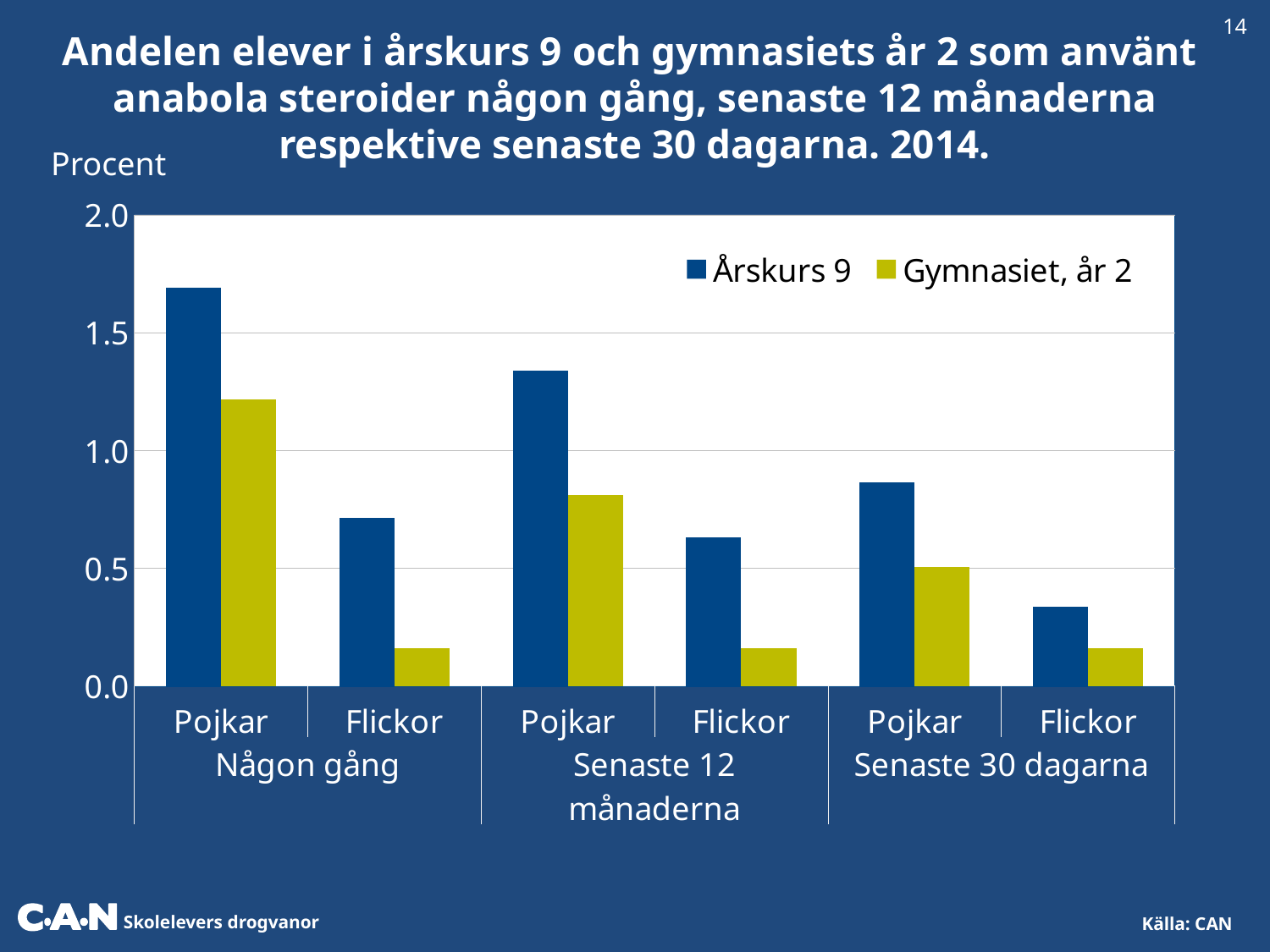
For Pojkar under Senaste 30 dagarna, which series has the larger value, Årskurs 9 or Gymnasiet, år 2? Årskurs 9 Is the value for Gymnasiet, år 2 Pojkar under Någon gång greater or less than 1.0? greater Is the value for Årskurs 9 Pojkar under Senaste 12 månaderna greater or less than 1.0? greater How many series does the legend list? 2 What are the two series named in the legend? Årskurs 9 and Gymnasiet, år 2 Is the value for Årskurs 9 Flickor under Senaste 30 dagarna greater or less than 0.5? less What kind of chart is shown on the slide? bar chart How many category groups (bar pairs) are plotted along the x axis? 6 What is the label on the vertical axis? Procent Which bar is the highest in the chart? Årskurs 9, Pojkar, Någon gång